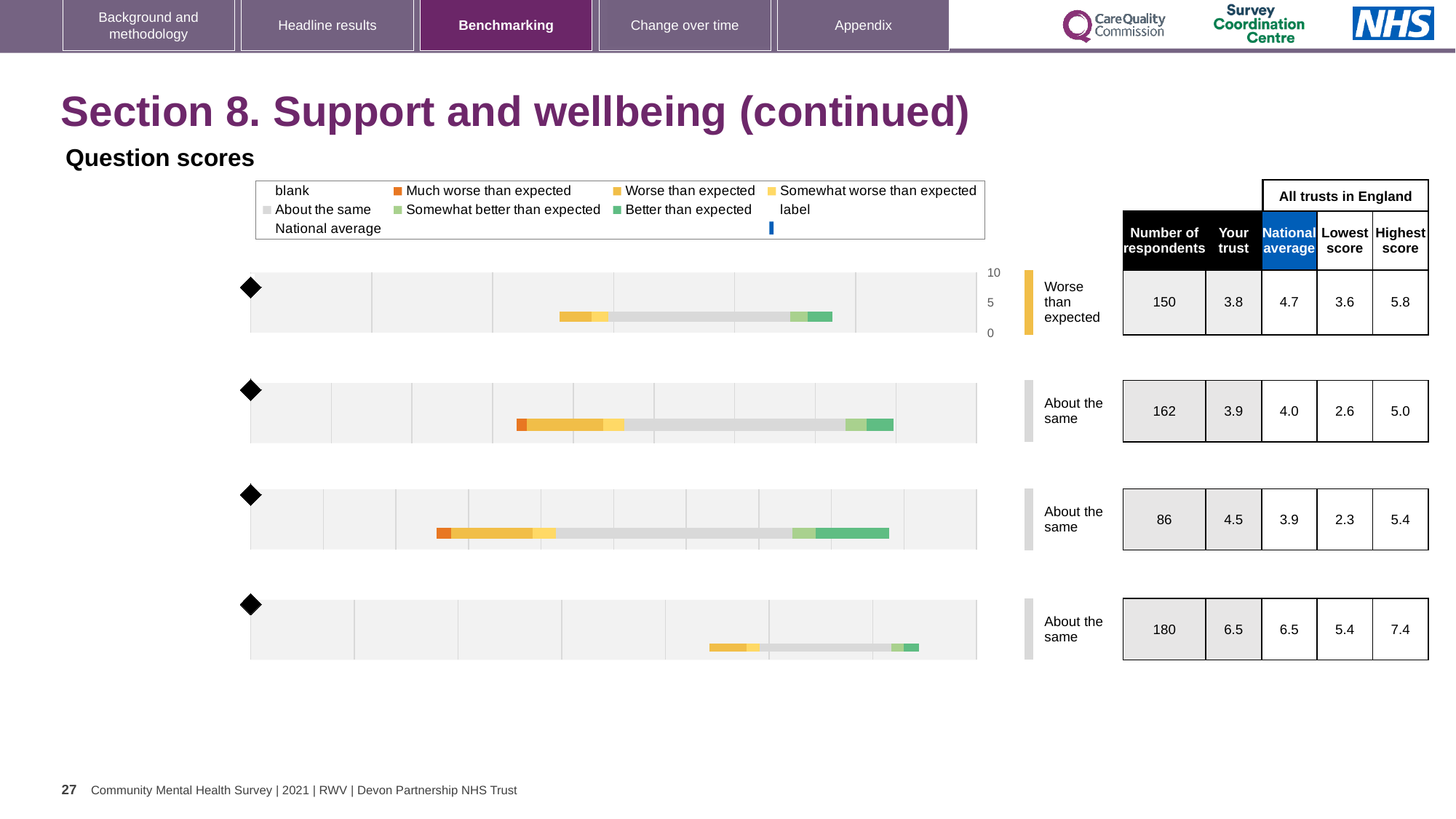
For the first (top) chart, what is the difference between the highest score and the lowest score across all trusts in England? 2.2 What kind of chart is used for the four question score charts on the slide? bar chart How many question score charts are shown on the slide? 4 For the third chart from the top, how many respondents are listed in the table? 86 For the first (top) chart, what is the national average score in the table? 4.7 For the first (top) chart, what is the 'Your trust' score in the table? 3.8 Which chart (by position from the top) has the highest 'Your trust' score in the table? fourth (bottom) chart For the fourth (bottom) chart, what is the highest score across all trusts in England? 7.4 For the third chart from the top, which is larger: the 'Your trust' score or the national average? Your trust What benchmark rating is shown next to the second chart from the top? About the same Which chart (by position from the top) has the lowest number of respondents in the table? third chart What benchmark rating is shown next to the first (top) chart? Worse than expected